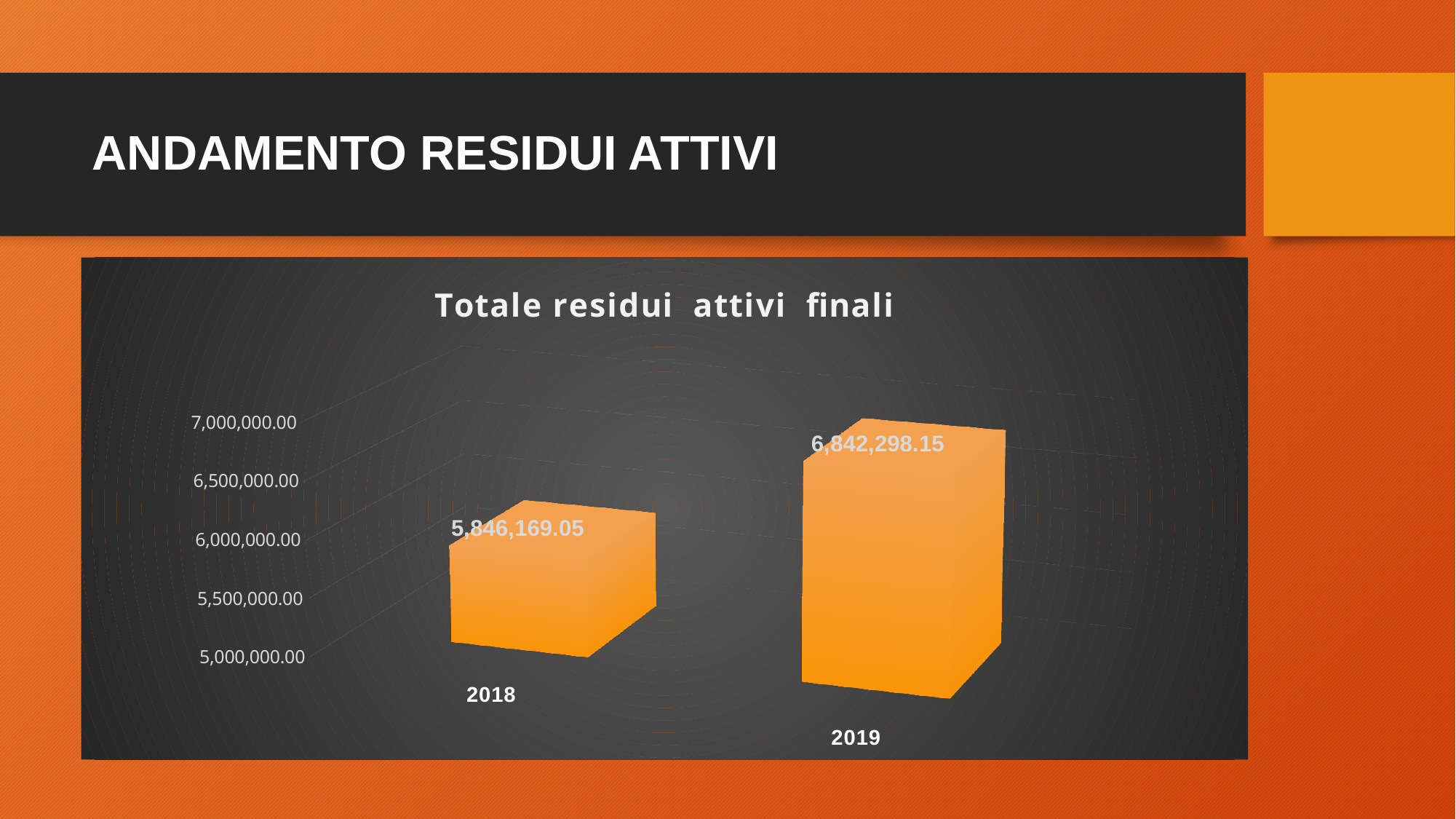
What is the title of the chart? Totale residui attivi finali Is the value for 2018 greater or less than 6,000,000.00? less How many categories are shown on the x axis? 2 What kind of chart is shown on the slide? bar chart Which year has the highest value? 2019 What is the value for 2019? 6,842,298.15 What is the value for 2018? 5,846,169.05 Which is larger, the value for 2018 or the value for 2019? 2019 What is the difference between the values for 2019 and 2018? 996,129.10 Do the values rise or fall from 2018 to 2019? rise Is the value for 2019 greater or less than 6,500,000.00? greater Which year has the lowest value? 2018